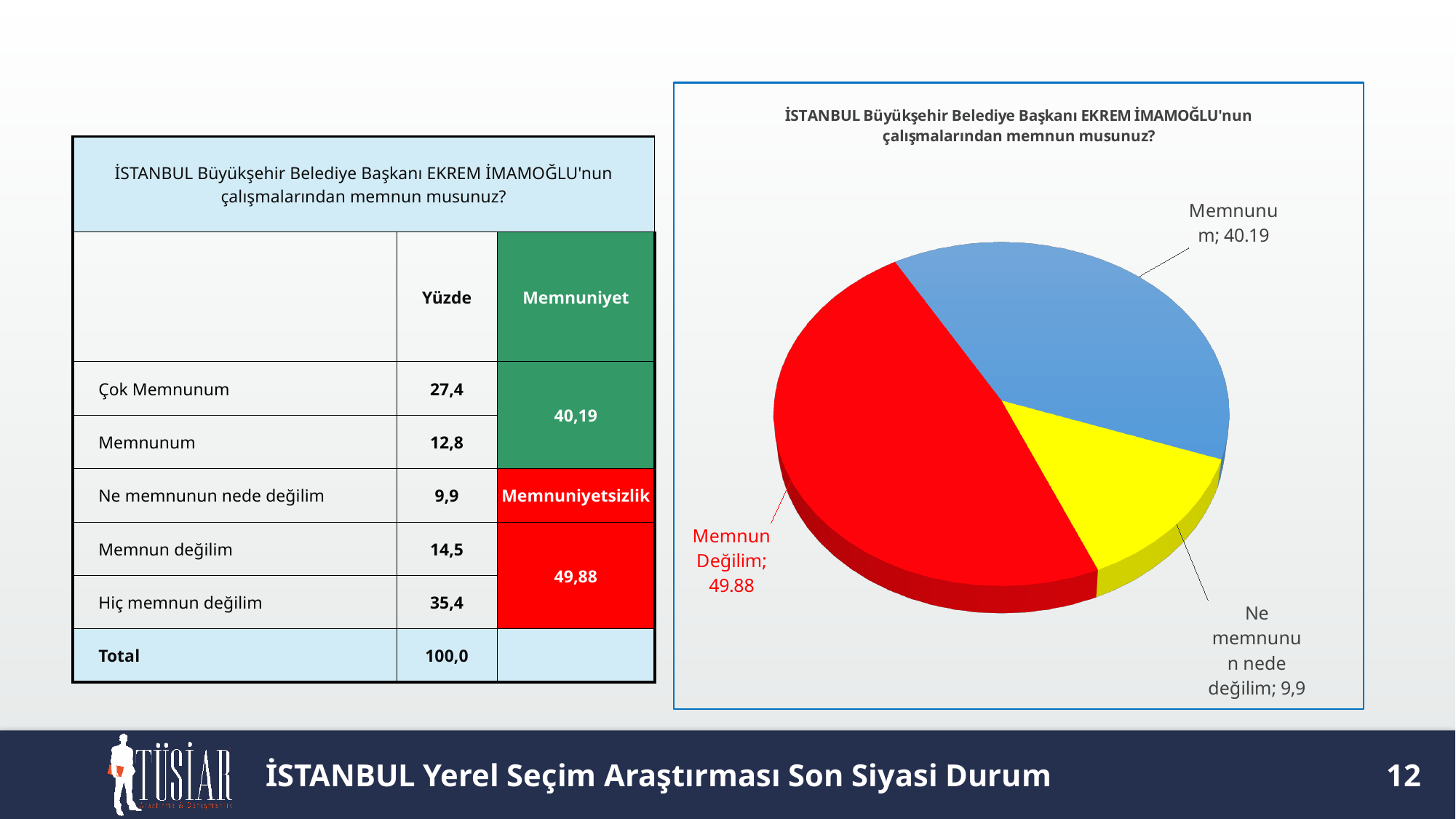
Which slice of the pie chart is the smallest? Ne memnunun nede değilim Which is larger in the pie chart, Memnunum or Memnun Değilim? Memnun Değilim Which slice of the pie chart is the largest? Memnun Değilim What is the value shown for the Memnunum slice of the pie chart? 40.19 What colour is the Ne memnunun nede değilim slice in the pie chart? Yellow What is the value shown for the Ne memnunun nede değilim slice of the pie chart? 9,9 How many slices does the pie chart have? 3 What colour is the Memnun Değilim slice in the pie chart? Red What is the difference between the Memnunum and Ne memnunun nede değilim values in the pie chart? 30.29 What kind of chart is shown on the slide? Pie chart What is the difference between the Memnun Değilim and Memnunum values in the pie chart? 9.69 What is the value shown for the Memnun Değilim slice of the pie chart? 49.88